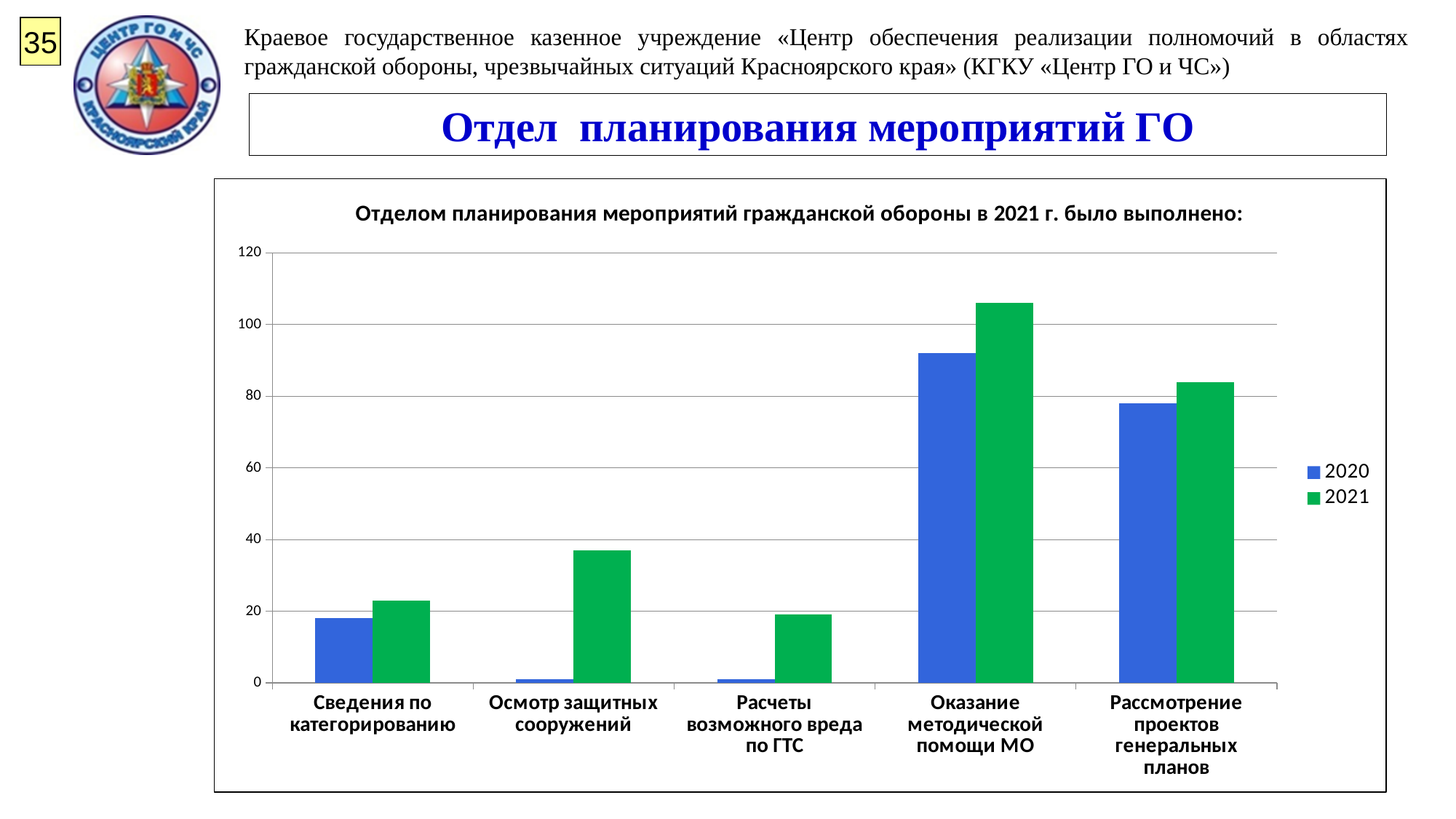
Is the 2020 value for Рассмотрение проектов генеральных планов greater or less than 60? greater Is the 2021 value for Осмотр защитных сооружений greater or less than 20? greater What are the two entries listed in the chart legend? 2020 and 2021 For Осмотр защитных сооружений, which series has the larger value, 2020 or 2021? 2021 How many series does the legend list? 2 How many categories are shown on the x axis? 5 Is the 2021 value for Оказание методической помощи МО greater or less than 100? greater Which category has the lowest value for the 2021 series? Расчеты возможного вреда по ГТС For the 2020 series, which is larger: Оказание методической помощи МО or Рассмотрение проектов генеральных планов? Оказание методической помощи МО Which category has the highest value for the 2021 series? Оказание методической помощи МО What kind of chart is shown on the slide? bar chart Which category has the highest value for the 2020 series? Оказание методической помощи МО